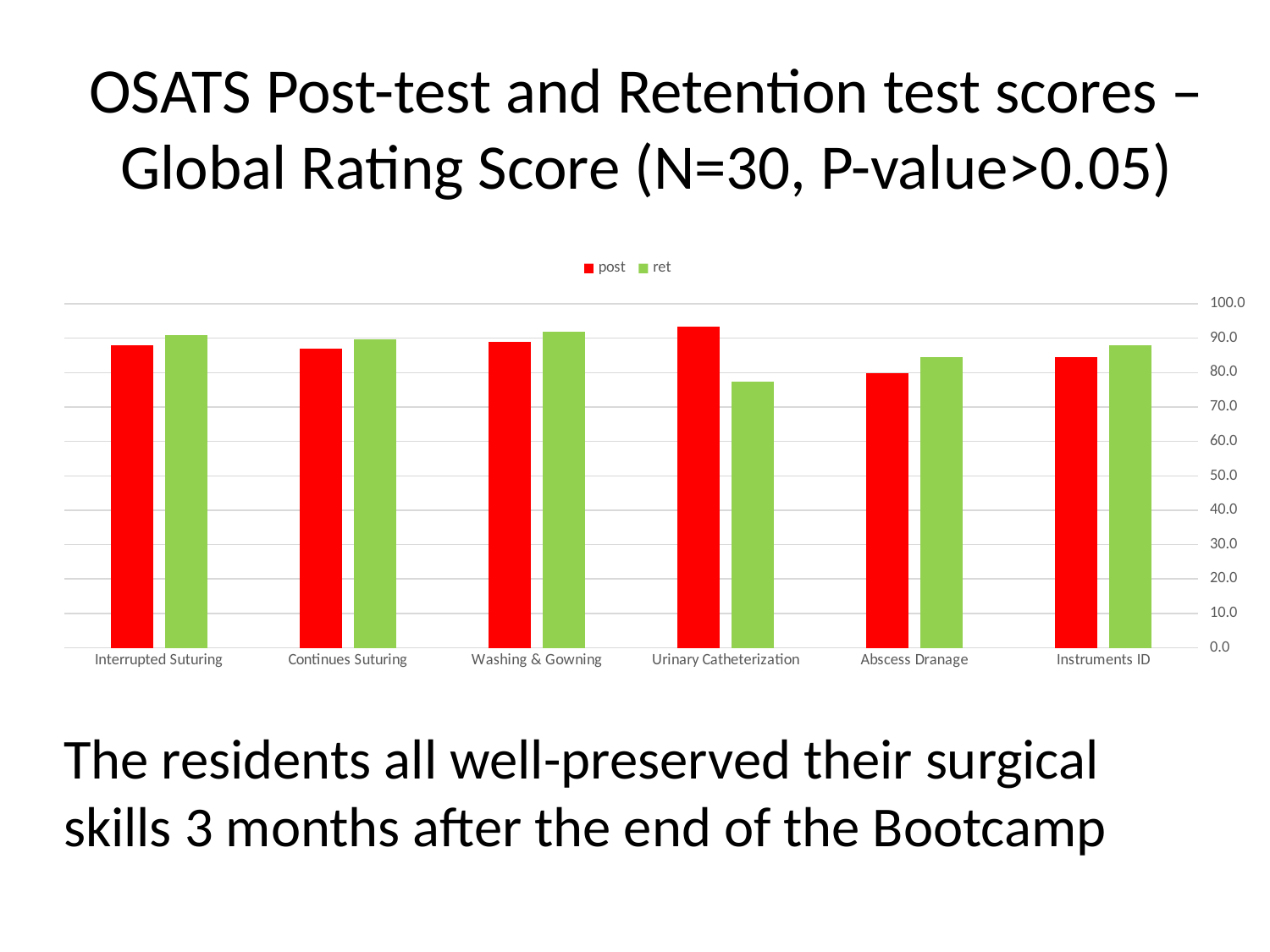
Is the ret value for Urinary Catheterization greater or less than 80.0? less How many series does the chart's legend list? 2 Which category has the highest post score? Urinary Catheterization Is the ret value for Instruments ID greater or less than 80.0? greater Which category has the lowest ret score? Urinary Catheterization Which category has the lowest post score? Abscess Dranage Is the post value for Urinary Catheterization greater or less than 90.0? greater What kind of chart is shown on the slide? bar chart For Urinary Catheterization, which is larger, the post score or the ret score? post What colour are the bars for the post series? red For Abscess Dranage, which is larger, the post score or the ret score? ret How many categories are shown on the x axis of the chart? 6